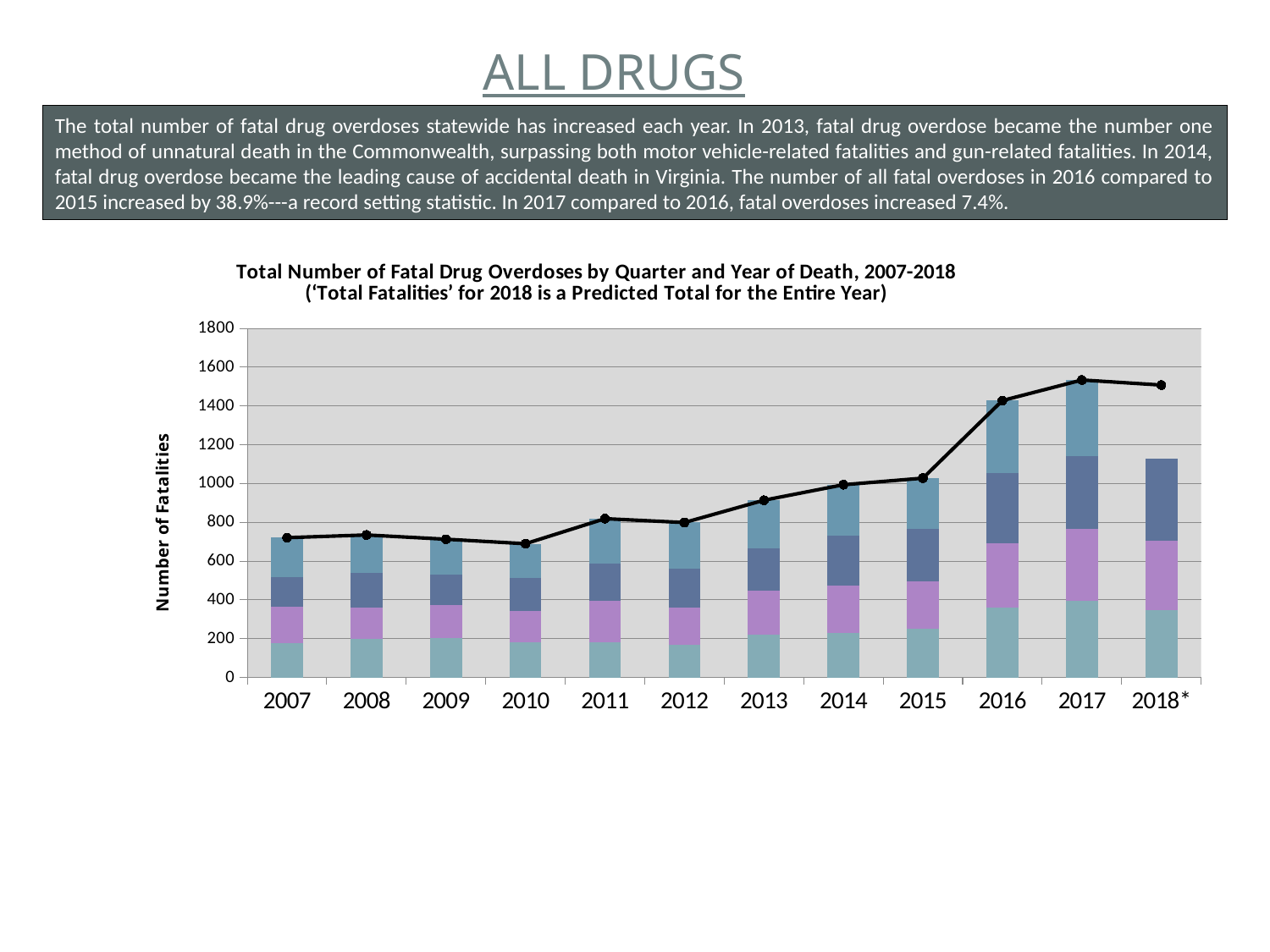
Is the total fatalities value for 2017 greater or less than 1400? greater Is the total fatalities value for 2018* greater or less than 1400? greater Is the total fatalities value for 2010 greater or less than 800? less What kind of chart is shown on the slide? A stacked bar chart with a line overlay Which year has the highest total fatalities according to the line? 2017 What is the label on the vertical axis of the chart? Number of Fatalities How many years are shown along the x axis of the chart? 12 Which year has the larger total fatalities, 2016 or 2017? 2017 Which year has the larger total fatalities, 2010 or 2011? 2011 Do total fatalities generally rise or fall from 2010 to 2017? Rise